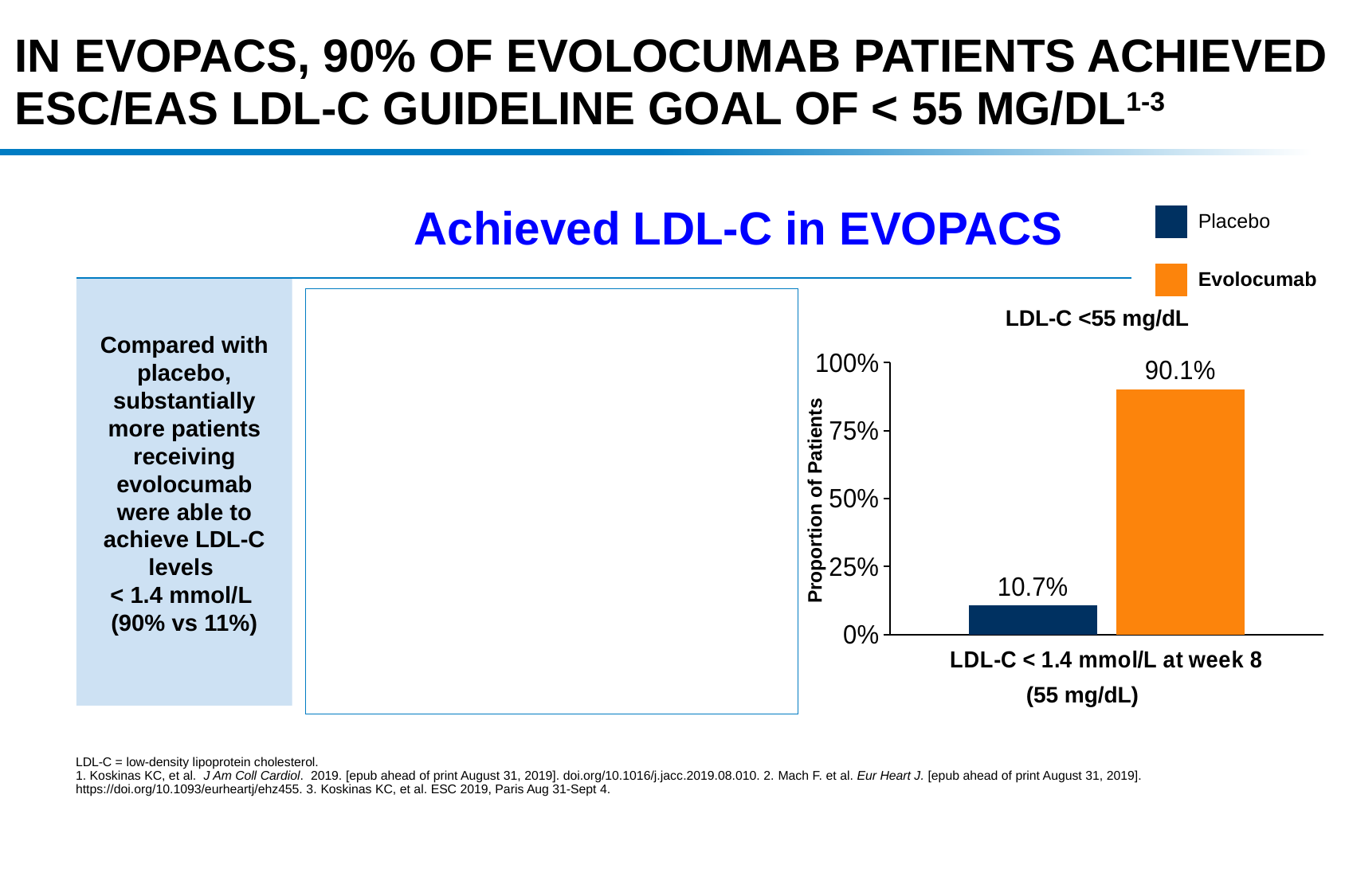
What proportion of evolocumab patients achieved LDL-C <55 mg/dL? 90.1% What is the title of the chart? Achieved LDL-C in EVOPACS What is the difference in percentage points between the evolocumab and placebo bars? 79.4 Is the evolocumab bar greater or less than 75%? greater Which group has the lower proportion of patients achieving LDL-C <55 mg/dL? Placebo What proportion of placebo patients achieved LDL-C <55 mg/dL? 10.7% Is the placebo bar greater or less than 25%? less How many series does the legend list? 2 Is the placebo value larger or smaller than the evolocumab value? smaller Which group has the higher proportion of patients achieving LDL-C <55 mg/dL? Evolocumab What kind of chart is shown? Bar chart What is the label of the y axis? Proportion of Patients